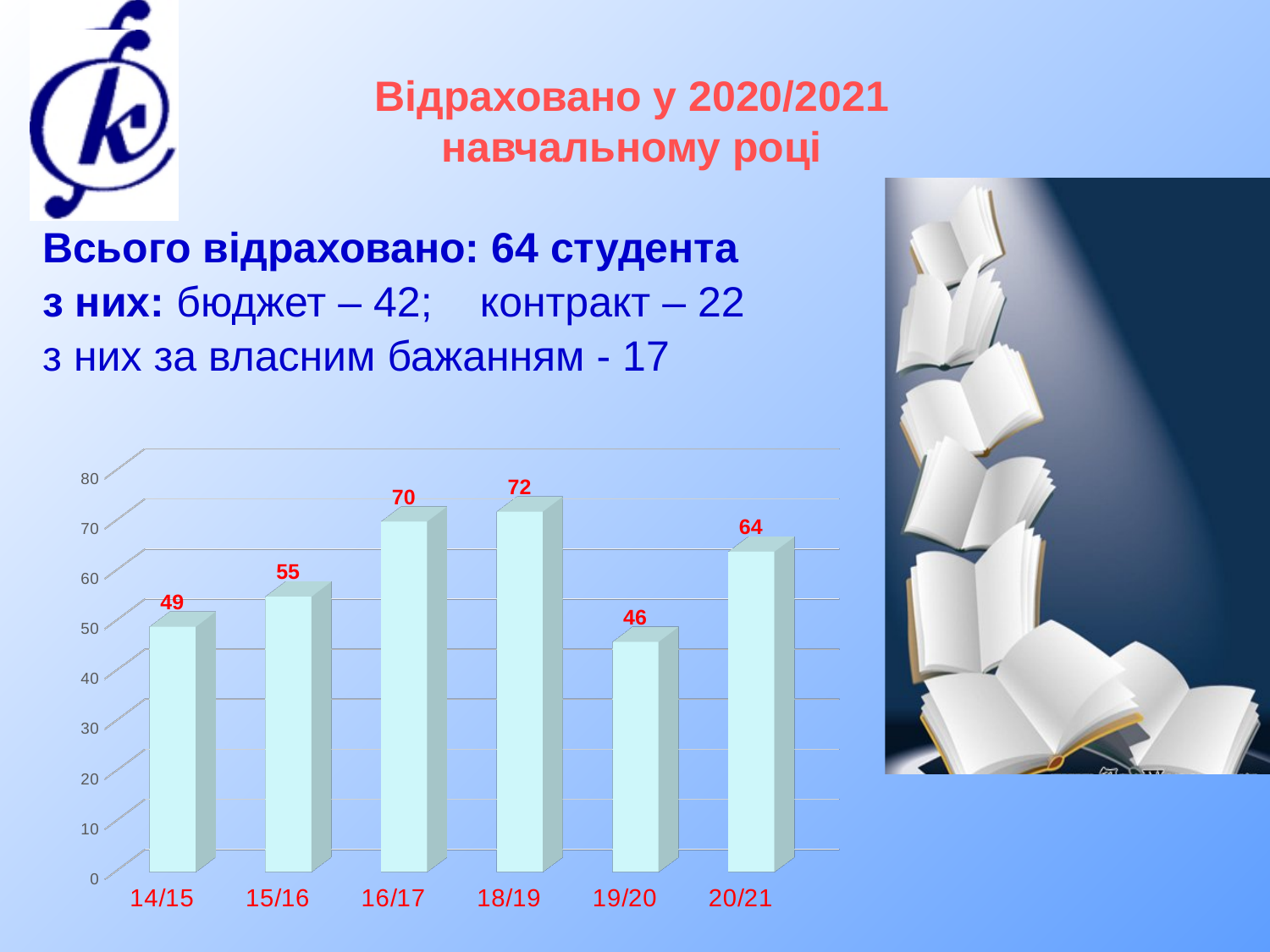
What is the difference between the values for 16/17 and 15/16? 15 How many academic years are shown on the x axis? 6 Which is larger, the value for 15/16 or the value for 20/21? 20/21 Which academic year has the lowest value? 19/20 What is the difference between the values for 18/19 and 19/20? 26 What kind of chart is shown on the slide? bar chart What value is shown for 14/15? 49 What value is shown for 19/20? 46 Is the value for 16/17 greater or less than 60? greater Which academic year has the highest value? 18/19 Does the value rise or fall from 18/19 to 19/20? fall What value is shown for 20/21? 64